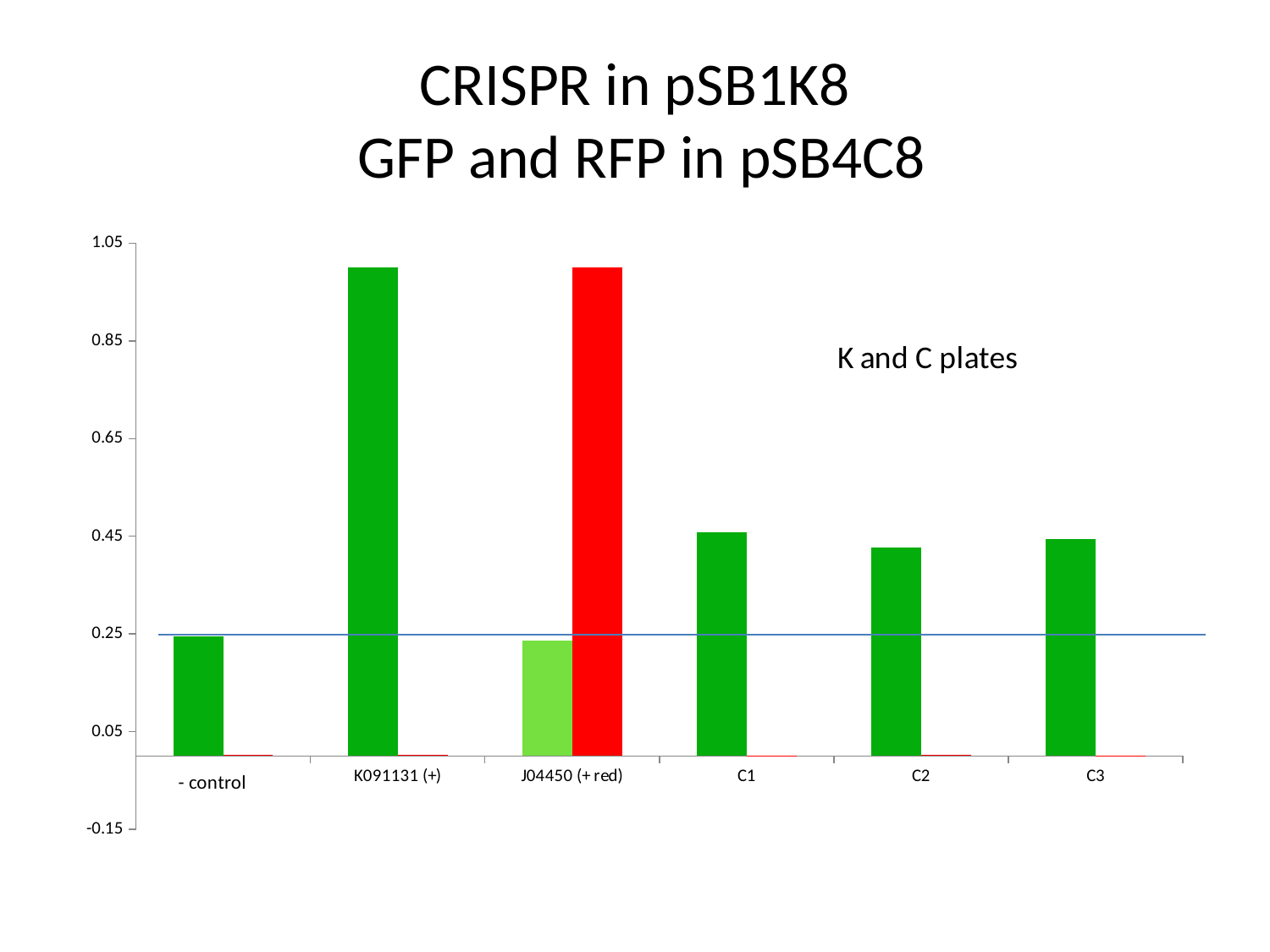
Is the green bar for - control greater or less than 0.45? less Is the red bar for J04450 (+ red) greater or less than 0.85? greater Which category has the tallest green bar? K091131 (+) What colour is the tallest bar for J04450 (+ red)? red Is the green bar for K091131 (+) greater or less than 0.85? greater Which has the taller green bar, C1 or - control? C1 How many categories are shown on the x axis of the chart? 6 What is the title of the slide? CRISPR in pSB1K8 GFP and RFP in pSB4C8 What kind of chart is shown on the slide? bar chart Which has the taller green bar, K091131 (+) or C1? K091131 (+)